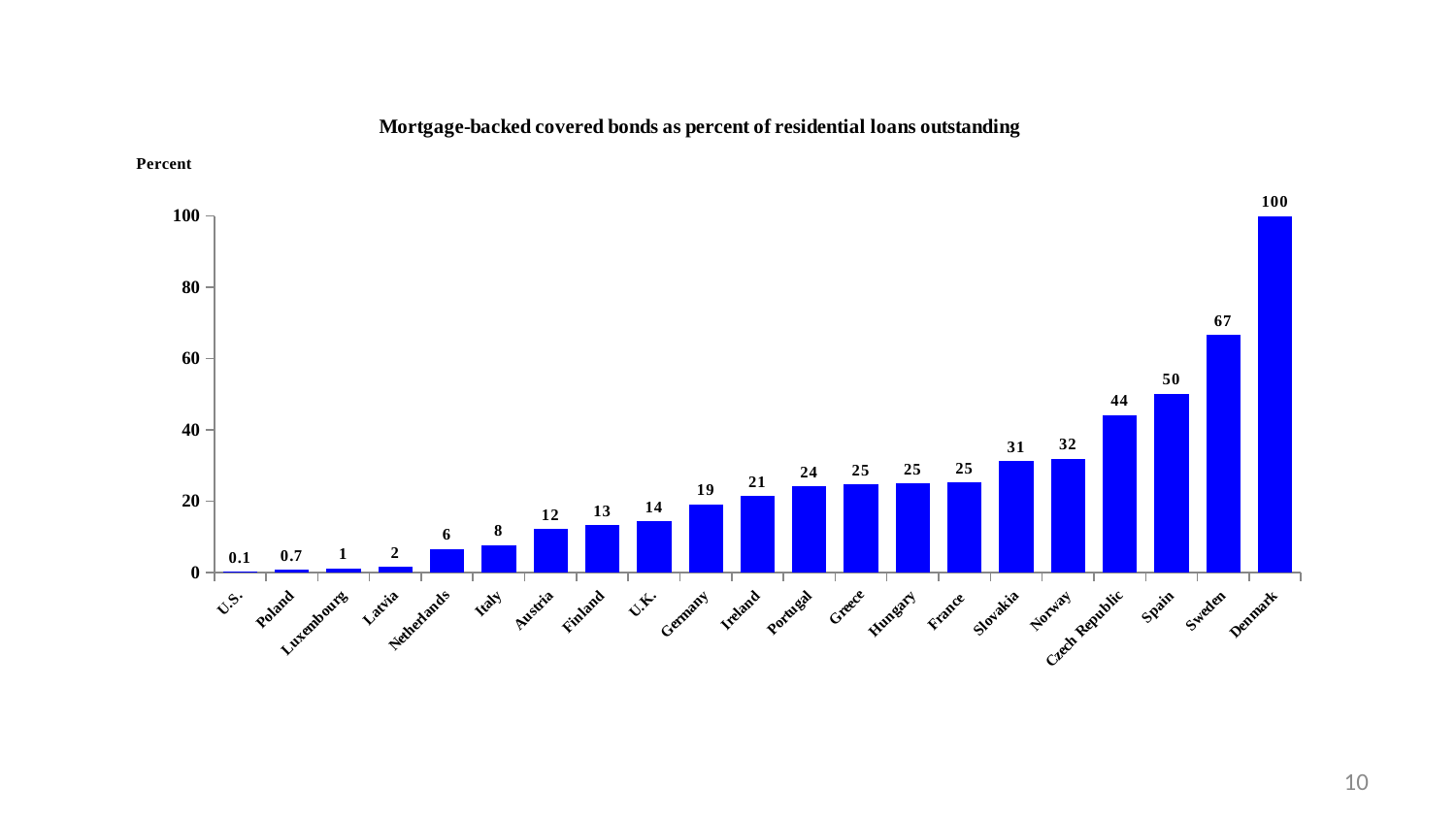
Do the values rise or fall from left to right along the x axis? Rise Which country has the lowest value? U.S. Which country has the highest value? Denmark What is the difference between the values for Sweden and Spain? 17 What is the title of the chart? Mortgage-backed covered bonds as percent of residential loans outstanding What kind of chart is this? Bar chart Is the value for Spain greater or less than 40? greater How many countries are shown on the chart? 21 Which has a larger value, Norway or Germany? Norway What is the value for the U.S.? 0.1 What is the value for Denmark? 100 What is the value for the Czech Republic? 44